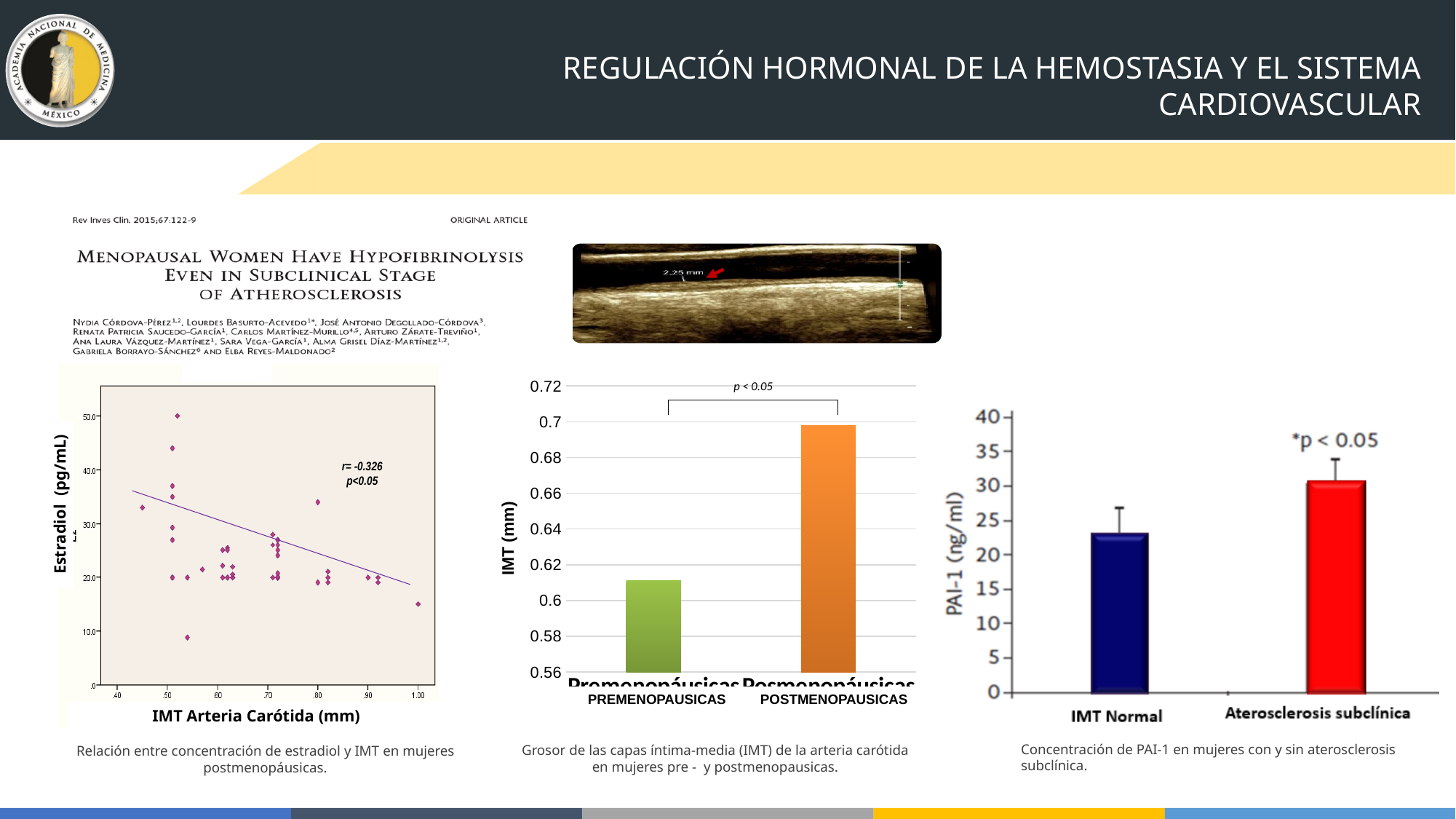
What kind of chart is the left chart relating Estradiol (pg/mL) to IMT Arteria Carótida (mm)? scatter plot In the right PAI-1 (ng/ml) bar chart, is the value for Aterosclerosis subclínica greater or less than 25? greater In the right PAI-1 (ng/ml) bar chart, what colour is the Aterosclerosis subclínica bar? red In the right PAI-1 (ng/ml) bar chart, is the value for IMT Normal greater or less than 25? less What kind of chart is the middle chart showing IMT (mm) for Premenopáusicas and Posmenopáusicas? bar chart In the middle IMT (mm) bar chart, which category has the higher value? Posmenopáusicas In the middle IMT (mm) bar chart, is the value for Premenopáusicas greater or less than 0.6? greater In the right PAI-1 (ng/ml) bar chart, which category has the lower value? IMT Normal What correlation coefficient is printed on the left scatter plot? r= -0.326 How many bars are plotted in the middle IMT (mm) bar chart? 2 In the left scatter plot, does Estradiol rise or fall as IMT Arteria Carótida increases along the x axis? fall